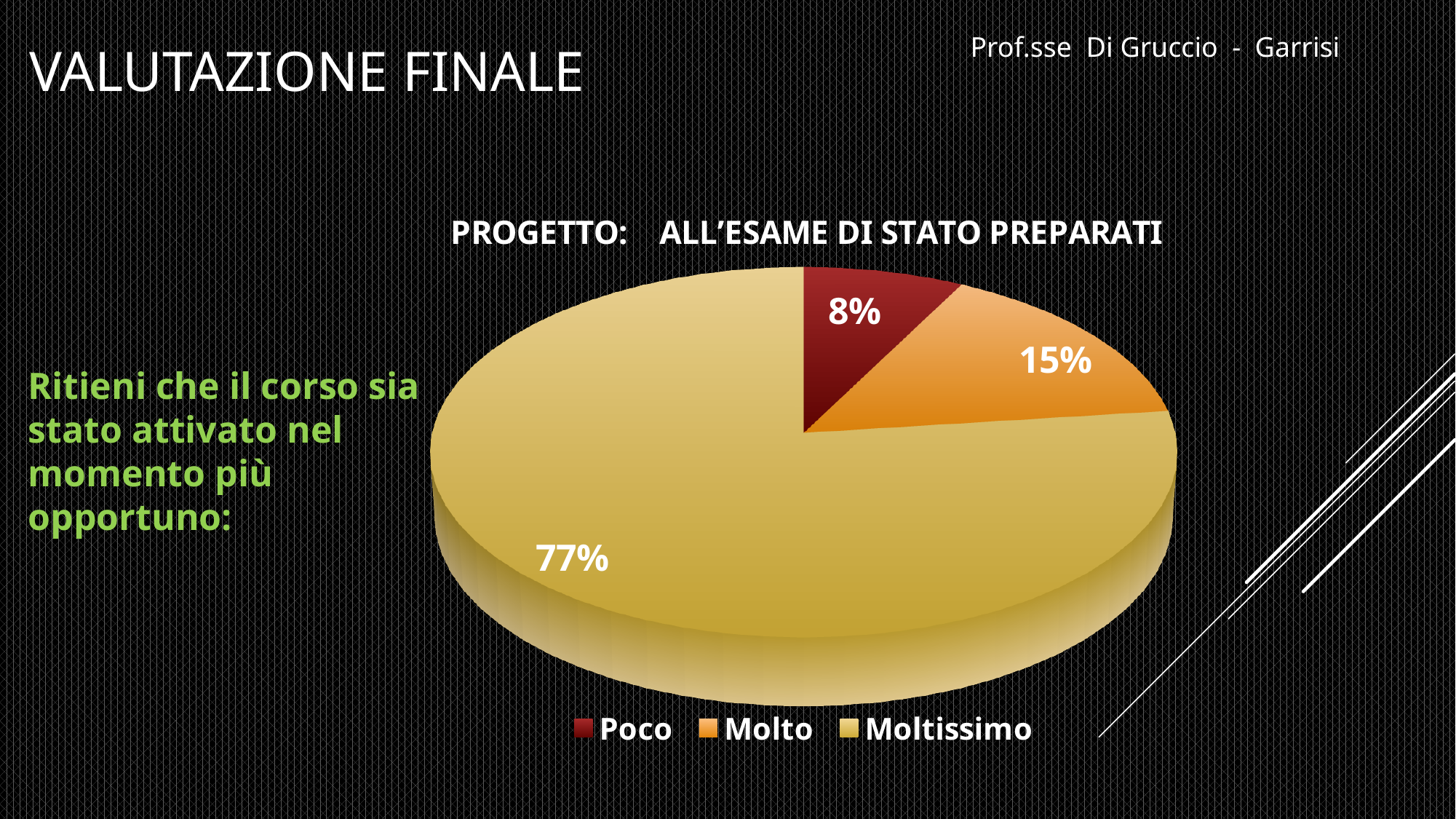
What percentage of the pie is labelled for Poco? 8% What is the title of the chart? PROGETTO: ALL'ESAME DI STATO PREPARATI What kind of chart is shown on the slide? Pie chart Which category has the largest slice of the pie? Moltissimo Which category has the smallest slice of the pie? Poco What is the difference in percentage points between the Moltissimo slice and the Molto slice? 62 What percentage of the pie is labelled for Molto? 15% Which slice is larger, Molto or Poco? Molto What is the difference in percentage points between the Molto slice and the Poco slice? 7 What percentage of the pie is labelled for Moltissimo? 77% What colour is the Poco slice in the pie chart? Dark red How many categories does the legend list? 3